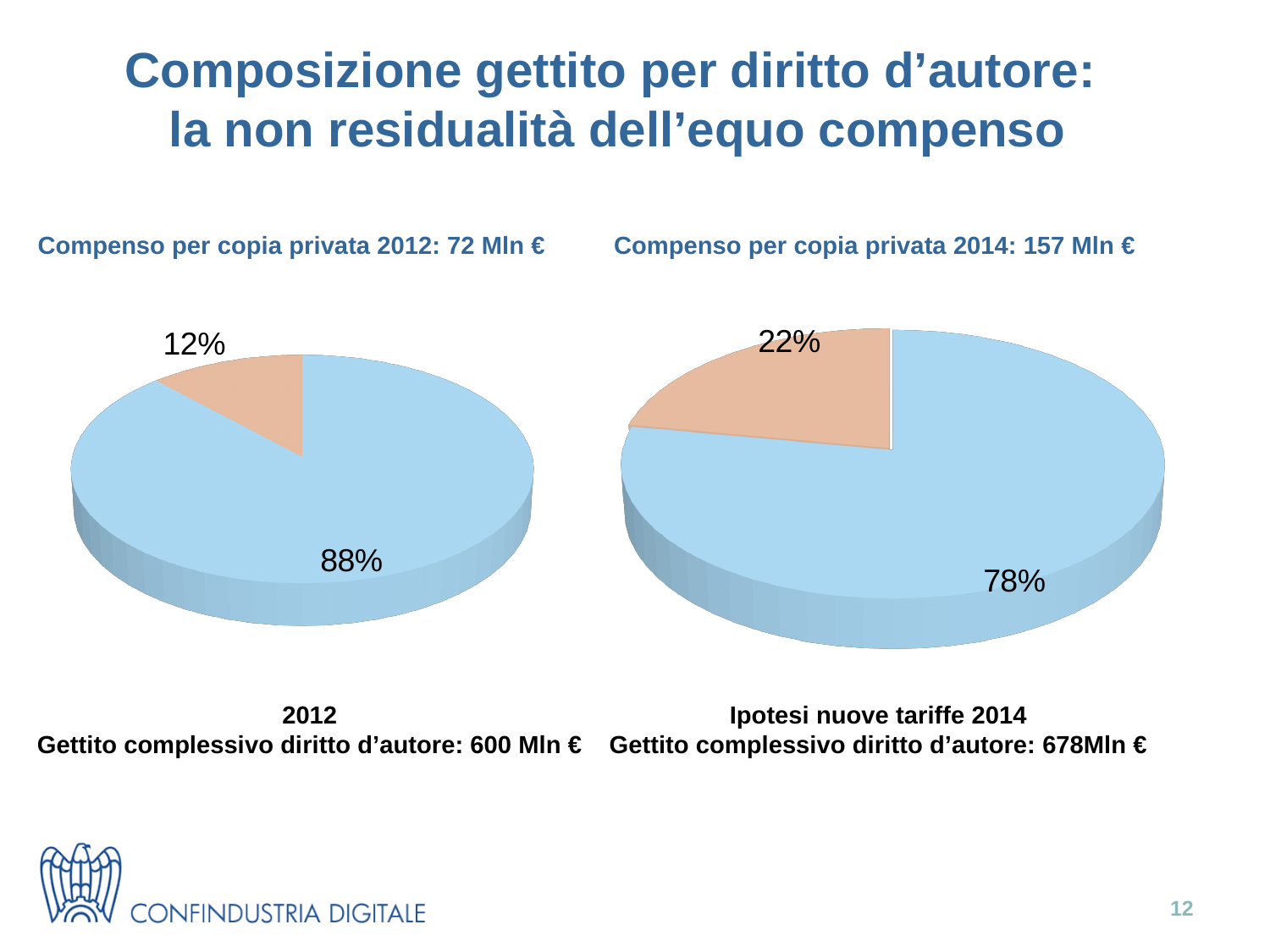
How many pie charts are on the slide? 2 Which slice is larger in the left pie chart (2012), the blue one or the orange one? The blue one What is the difference between the blue slice and the orange slice in the right pie chart (2014)? 56 percentage points According to the caption below the right pie chart, what is the gettito complessivo diritto d'autore for the 2014 hypothesis? 678Mln € What kind of charts are shown on the slide? Pie charts In the left pie chart (2012), what share does the orange slice represent? 12% In the right pie chart (Ipotesi nuove tariffe 2014), what share does the orange slice represent? 22% In the right pie chart (Ipotesi nuove tariffe 2014), what share does the blue slice represent? 78% How many slices does each pie chart have? 2 According to the label above the left pie chart, what is the compenso per copia privata for 2012? 72 Mln € By how many percentage points does the orange slice grow from the 2012 pie chart to the 2014 pie chart? 10 percentage points